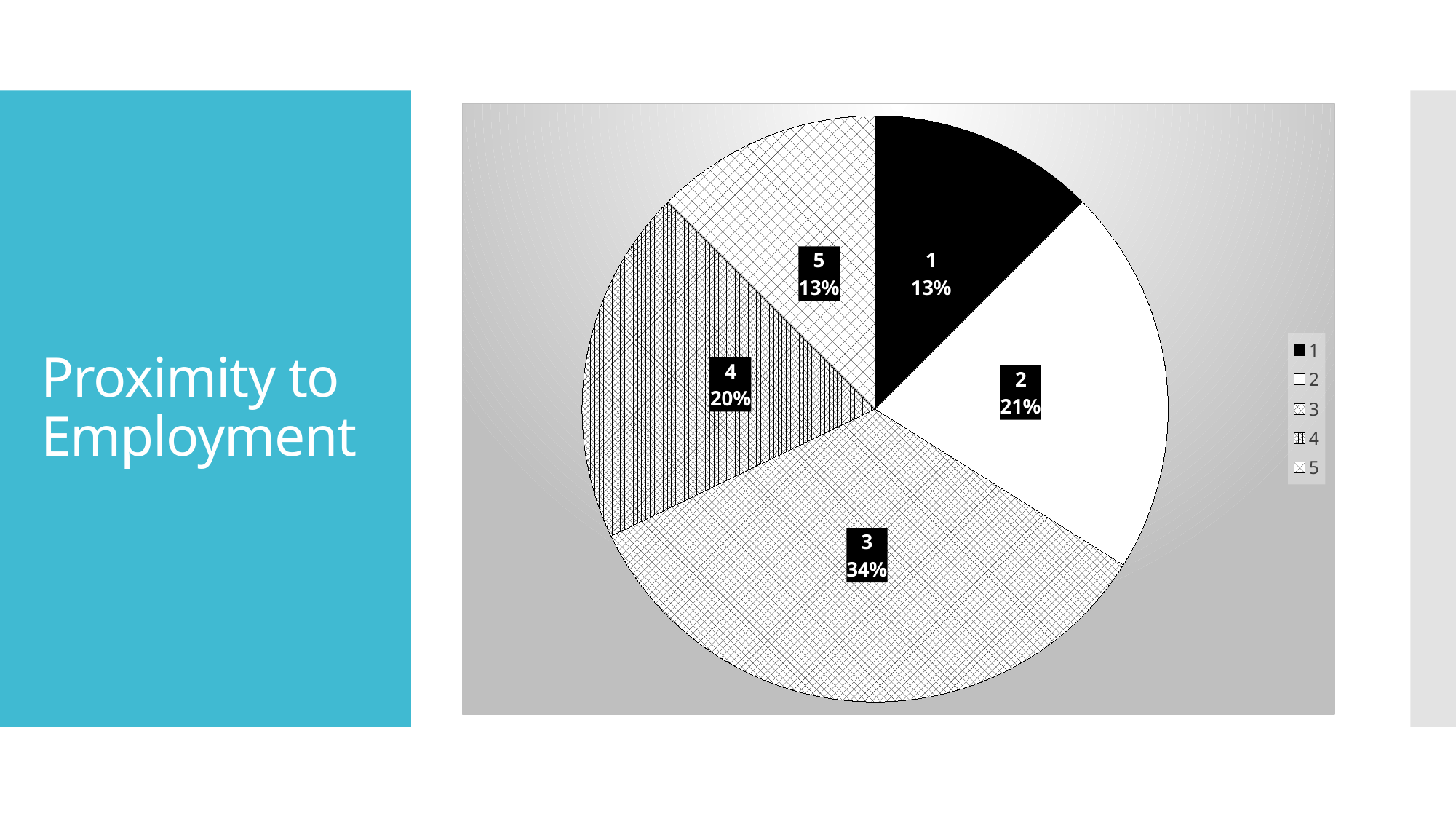
What is the difference in percentage points between category 3 and category 2? 13 What share of the pie does category 3 represent? 34% What is the difference in percentage points between category 4 and category 5? 7 What share of the pie does category 4 represent? 20% Which slice of the pie is filled solid black? 1 Which category has the largest slice of the pie? 3 What share of the pie does category 1 represent? 13% Which slice is larger, category 2 or category 4? 2 How many slices does the pie chart have? 5 How many entries does the legend list? 5 What kind of chart is shown on the slide? pie chart